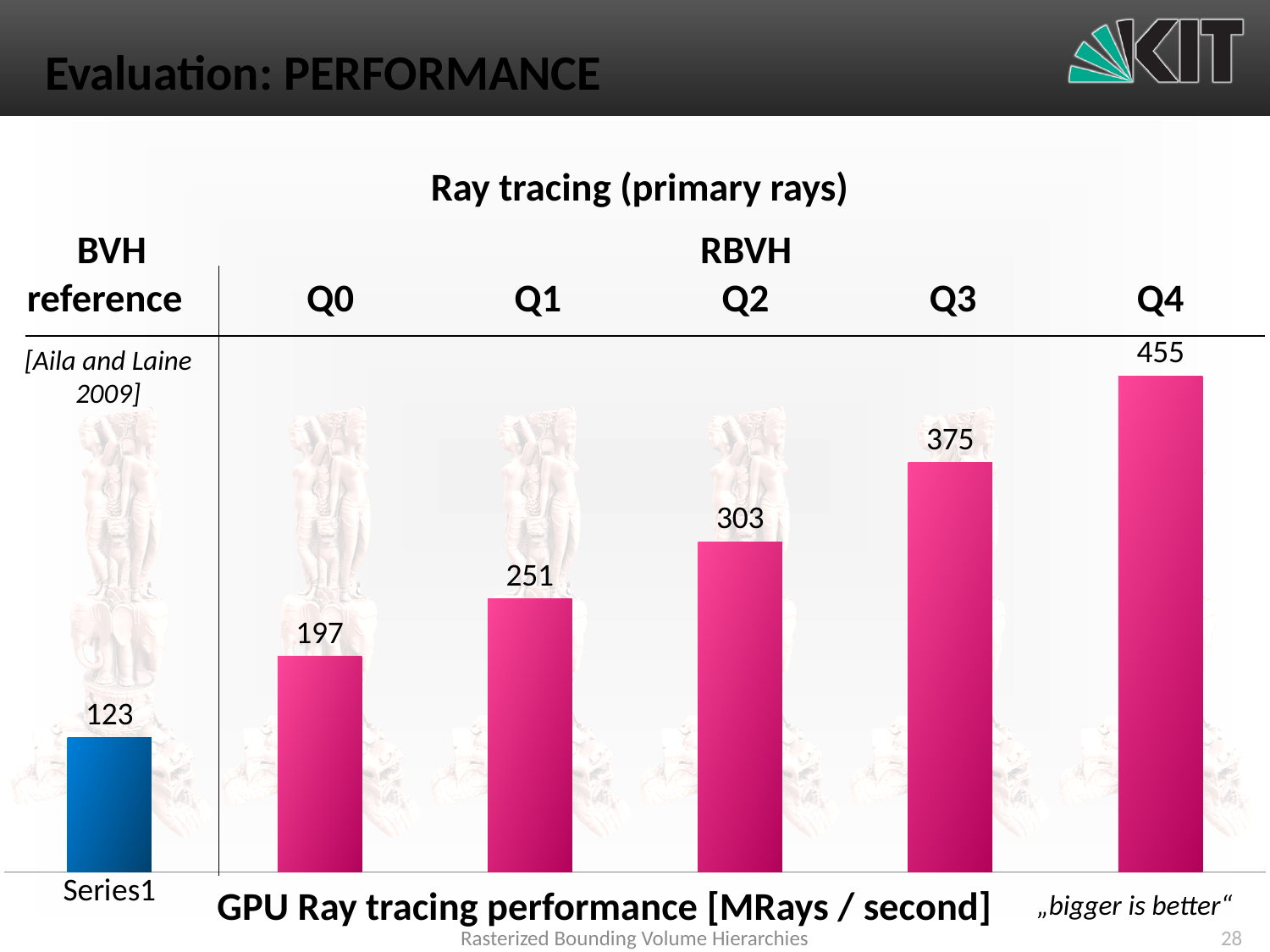
What is the GPU ray tracing performance value for Q4? 455 Which is larger, the value for Q1 or the value for Q2? Q2 How many bars are plotted in the chart? 6 What is the value shown for Q0? 197 What is the difference between the Q3 and Q1 values? 124 Which bar has the lowest value? BVH reference Do the values rise or fall from Q0 to Q4? Rise What kind of chart is shown on the slide? Bar chart What is the value shown for the BVH reference bar? 123 Which bar has the highest value? Q4 What is the value shown for Q2? 303 What is the difference between the Q4 value and the BVH reference value? 332